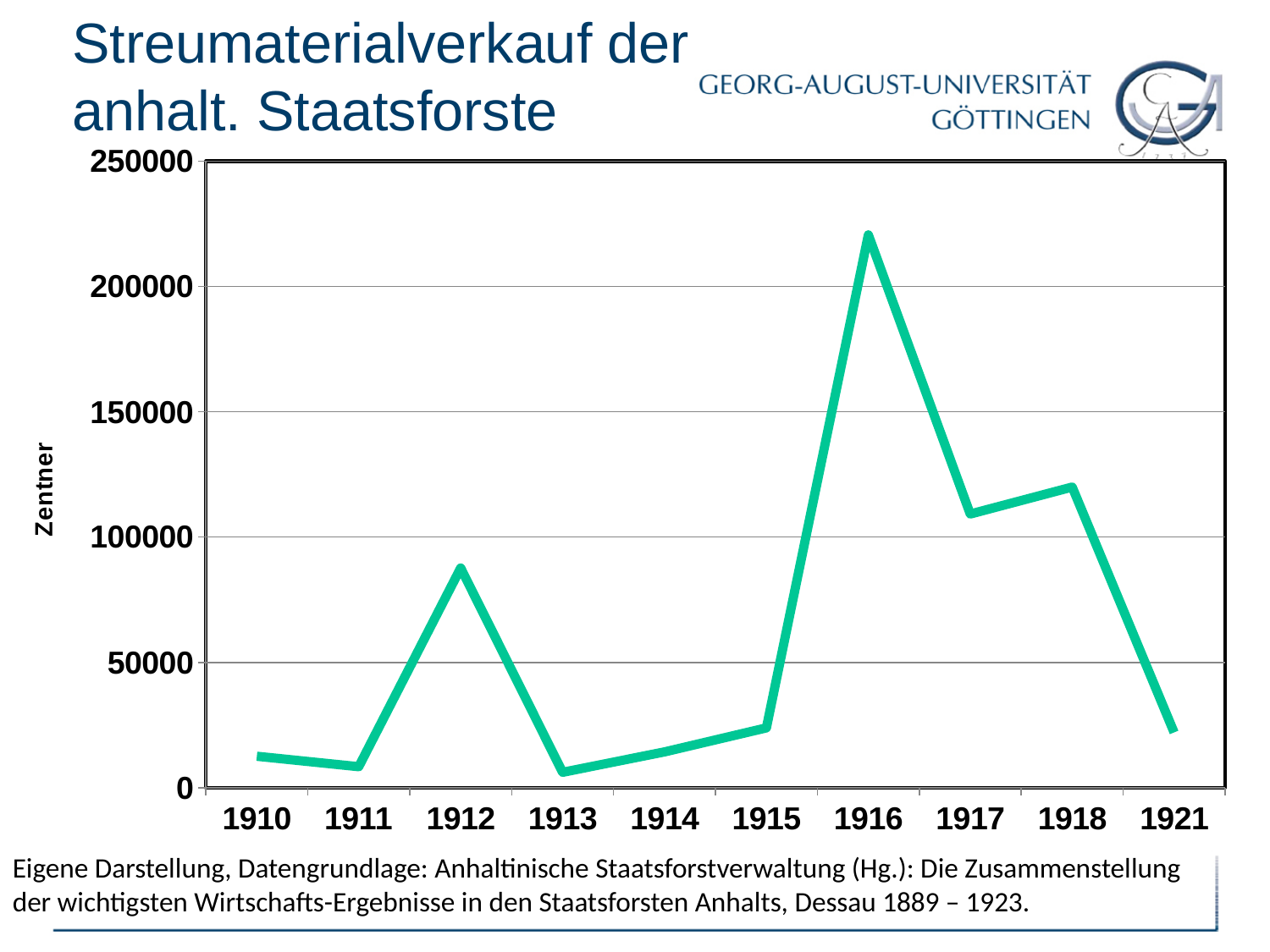
Which year has the highest value? 1916 Is the value for 1916 greater or less than 200000? greater Is the value for 1921 greater or less than 50000? less How many years are plotted along the x axis? 10 Is the value for 1917 greater or less than 100000? greater Does the value rise or fall from 1916 to 1917? fall Does the value rise or fall from 1913 to 1916? rise What kind of chart is shown on the slide? line chart Which is larger, the value for 1912 or the value for 1917? 1917 What is the label on the y axis? Zentner